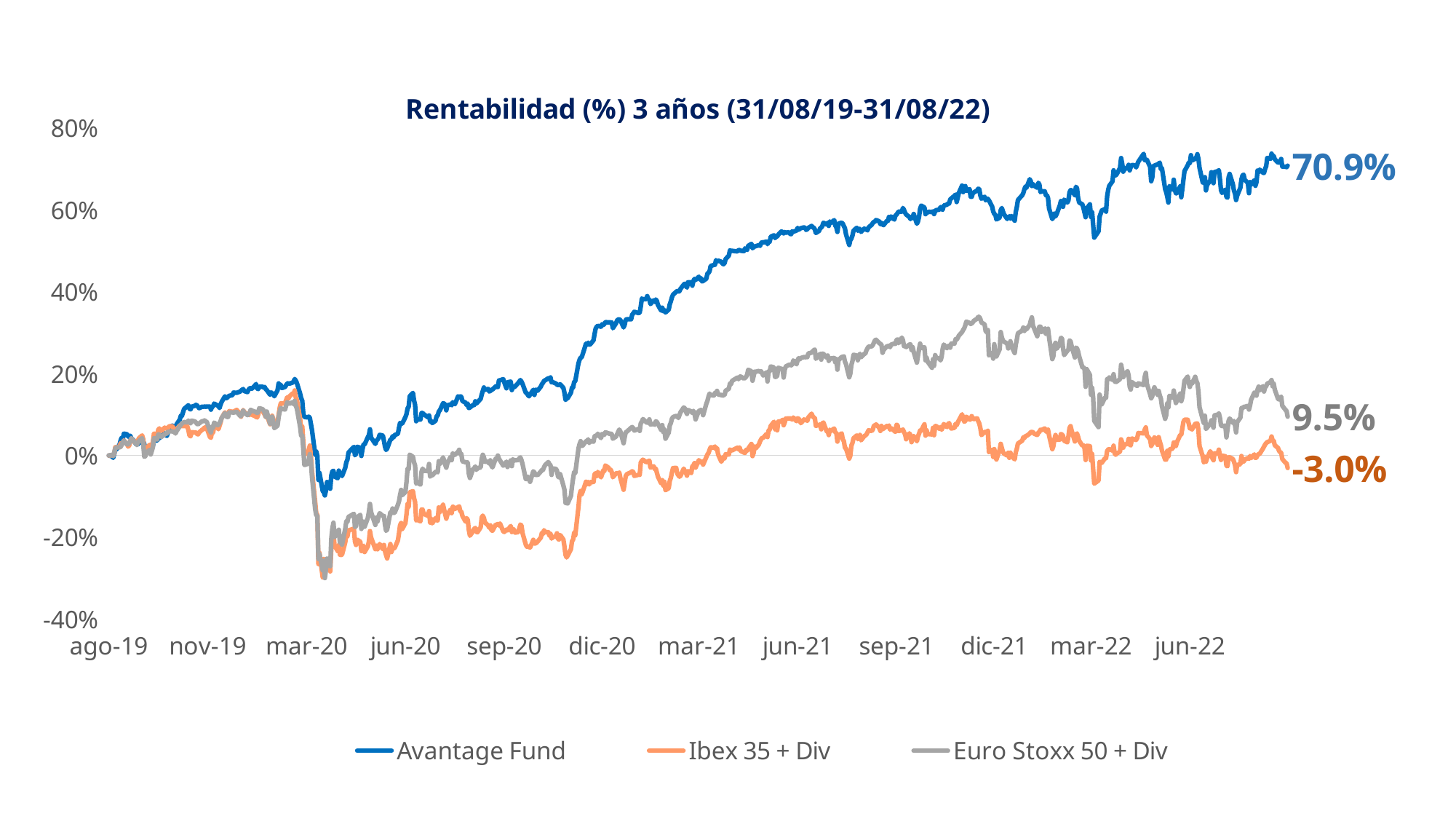
Which series has the lowest final value? Ibex 35 + Div What kind of chart is shown on the slide? Line chart What is the difference between the final values of Euro Stoxx 50 + Div and Ibex 35 + Div? 12.5 percentage points What is the difference between the final values of Avantage Fund and Euro Stoxx 50 + Div? 61.4 percentage points What is the final value shown for Ibex 35 + Div? -3.0% What is the final value shown for Euro Stoxx 50 + Div? 9.5% Which has a larger final value, Euro Stoxx 50 + Div or Ibex 35 + Div? Euro Stoxx 50 + Div Which series has the highest final value? Avantage Fund What is the final value shown for Avantage Fund at the end of the period? 70.9% What is the title of the chart? Rentabilidad (%) 3 años (31/08/19-31/08/22) How many series does the legend list? 3 Is the Avantage Fund value around jun-21 greater or less than 40%? greater